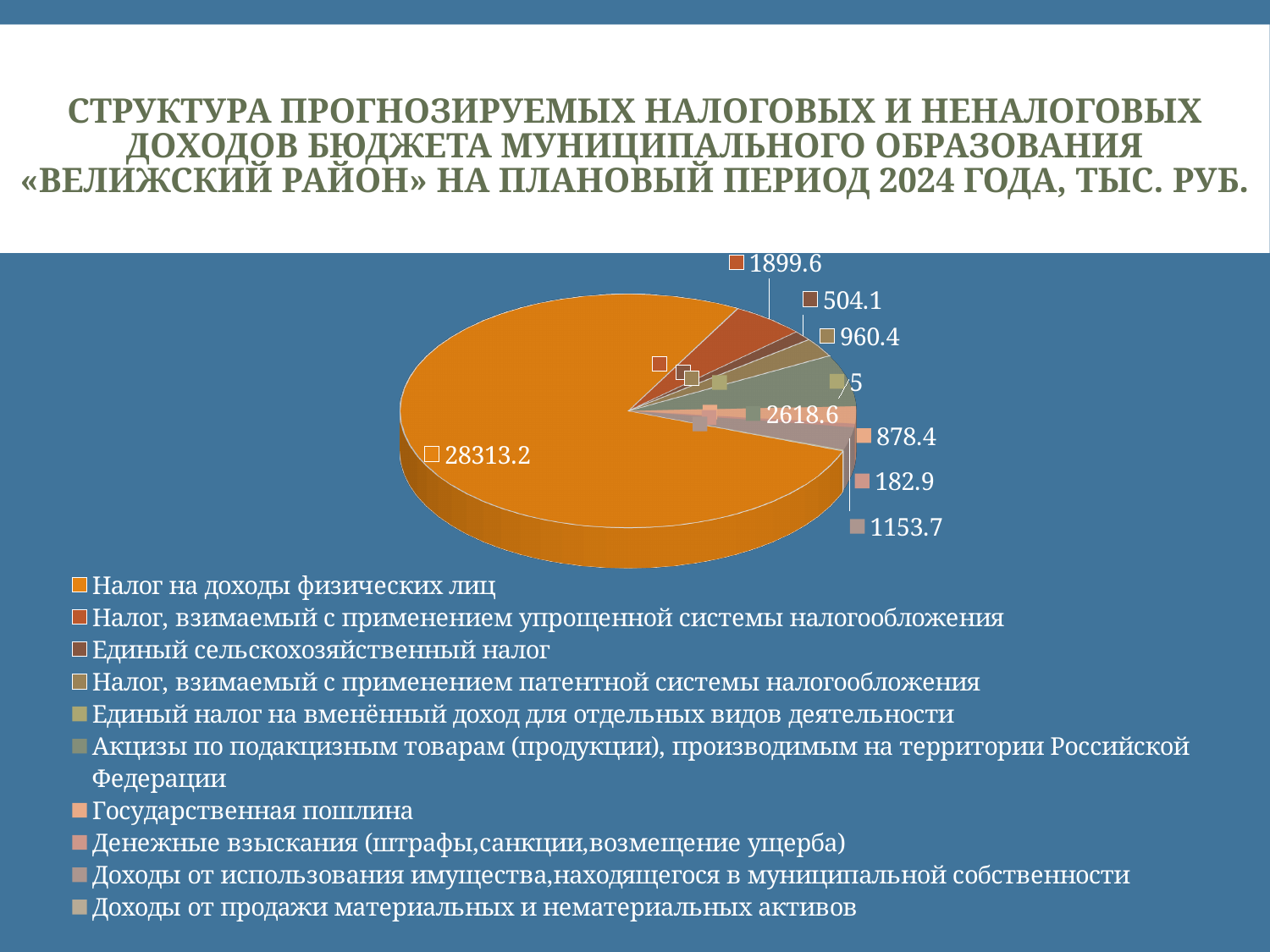
What is the difference between the value for Налог, взимаемый с применением упрощенной системы налогообложения (1899.6) and Единый сельскохозяйственный налог (504.1)? 1395.5 Which is larger: Налог на доходы физических лиц or Акцизы по подакцизным товарам? Налог на доходы физических лиц What kind of chart is shown on the slide? pie chart What unit of measurement is stated in the chart title? тыс. руб. How many categories does the legend list? 10 What is the value for Налог на доходы физических лиц? 28313.2 What is the value for Налог, взимаемый с применением упрощенной системы налогообложения? 1899.6 What is the value for Доходы от использования имущества, находящегося в муниципальной собственности? 1153.7 What is the value for Акцизы по подакцизным товарам (продукции), производимым на территории Российской Федерации? 2618.6 What is the value for Единый сельскохозяйственный налог? 504.1 What is the value for Государственная пошлина? 878.4 Which category has the largest slice of the pie? Налог на доходы физических лиц